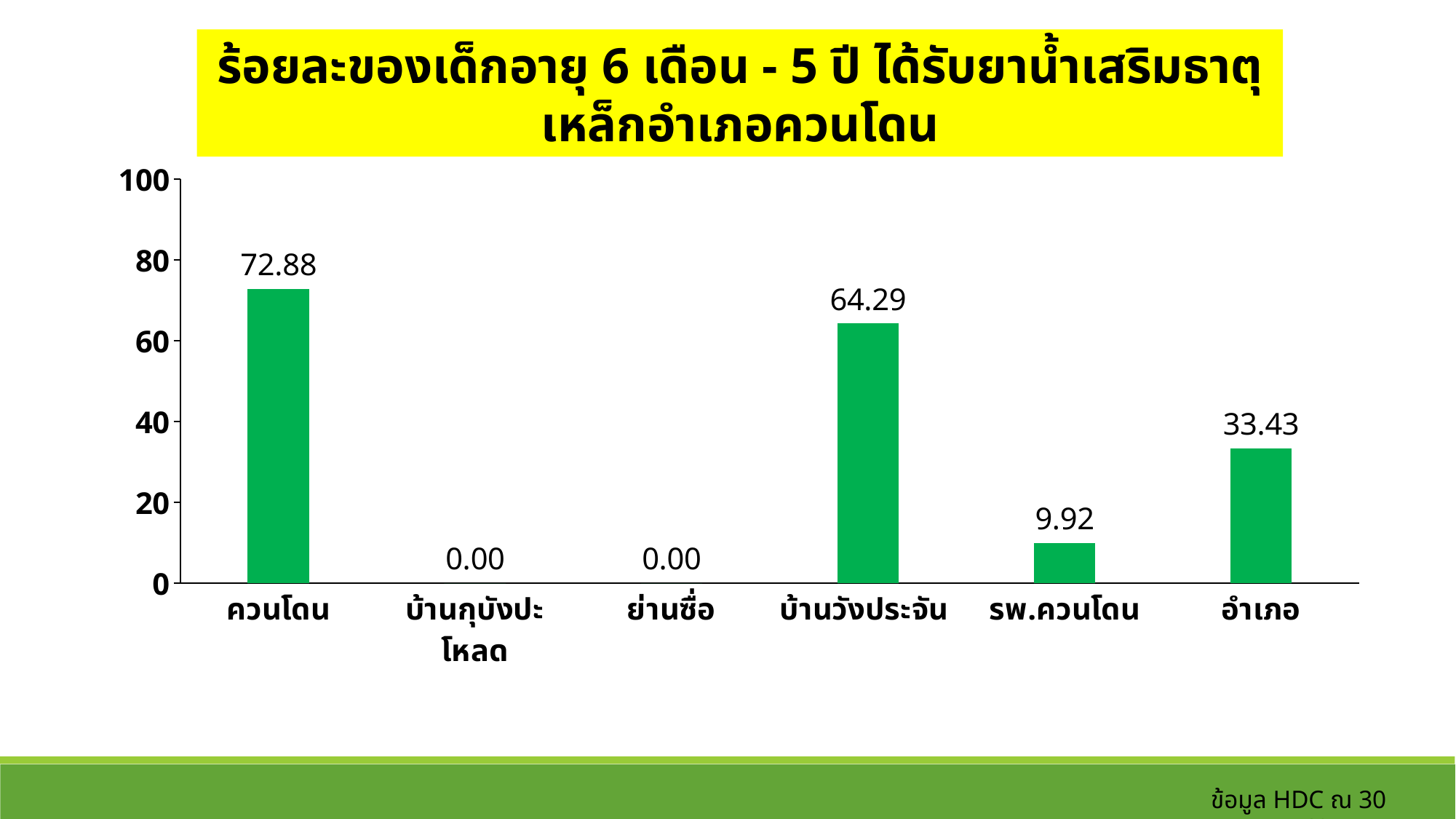
What is the difference between the values for ควนโดน and บ้านวังประจัน? 8.59 What is the difference between the values for อำเภอ and รพ.ควนโดน? 23.51 Is the value for รพ.ควนโดน greater or less than 20? less What kind of chart is shown on the slide? bar chart Which is larger, the value for บ้านวังประจัน or the value for อำเภอ? บ้านวังประจัน What is the value for ควนโดน? 72.88 What is the value for รพ.ควนโดน? 9.92 What is the value for อำเภอ? 33.43 Which category has the highest value? ควนโดน How many categories are shown on the x axis? 6 What is the value for บ้านวังประจัน? 64.29 What is the value for ย่านซื่อ? 0.00